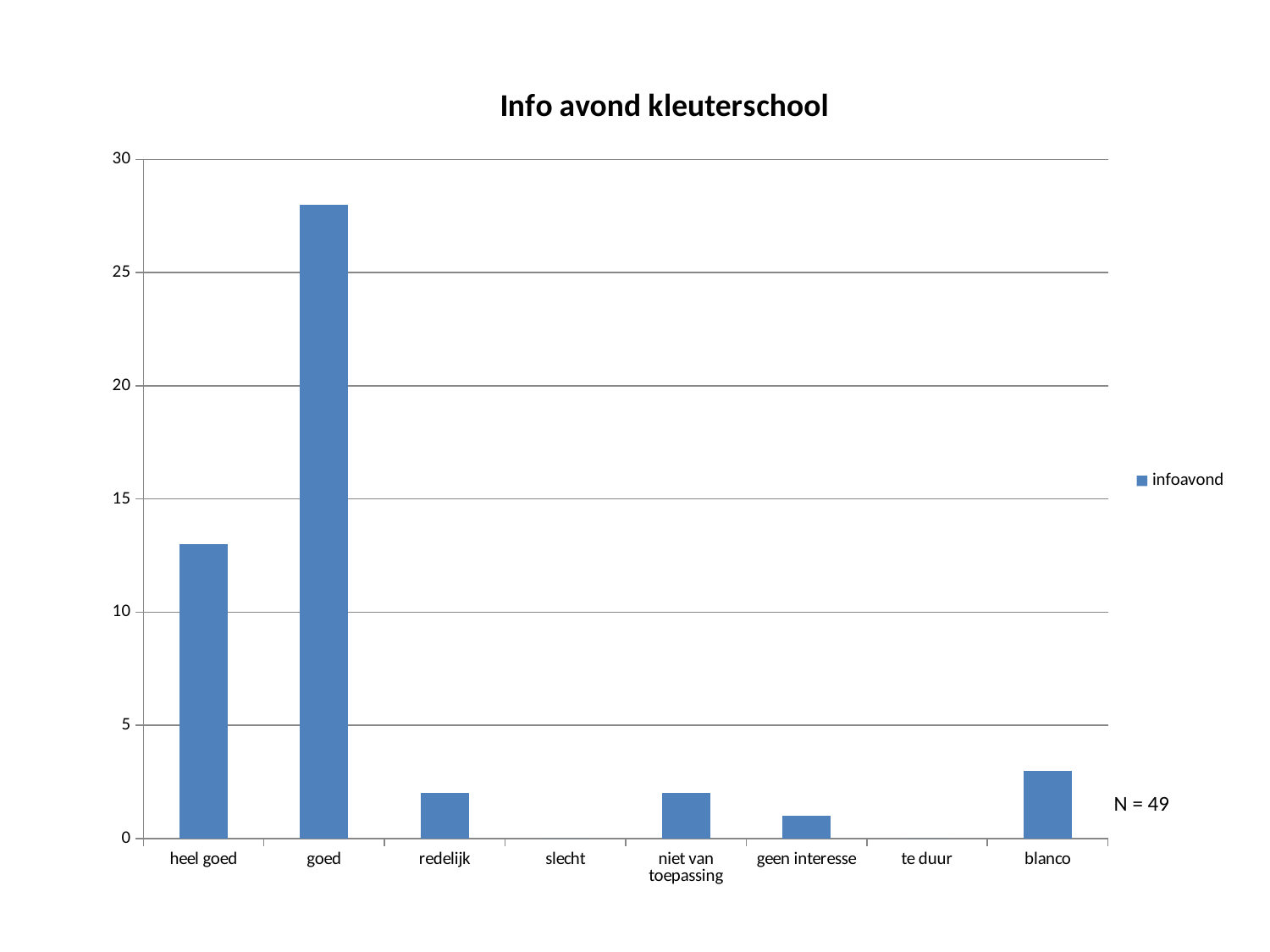
What is the title of the chart? Info avond kleuterschool What kind of chart is shown on the slide? bar chart Is the value for heel goed greater or less than 10? greater How many series does the legend list? 1 Which category has the highest value? goed What is the name of the series shown in the legend? infoavond Is the value for blanco greater or less than 5? less Which is larger, the value for heel goed or the value for goed? goed Is the value for heel goed greater or less than 15? less Which is larger, the value for blanco or the value for geen interesse? blanco How many categories are shown on the x axis? 8